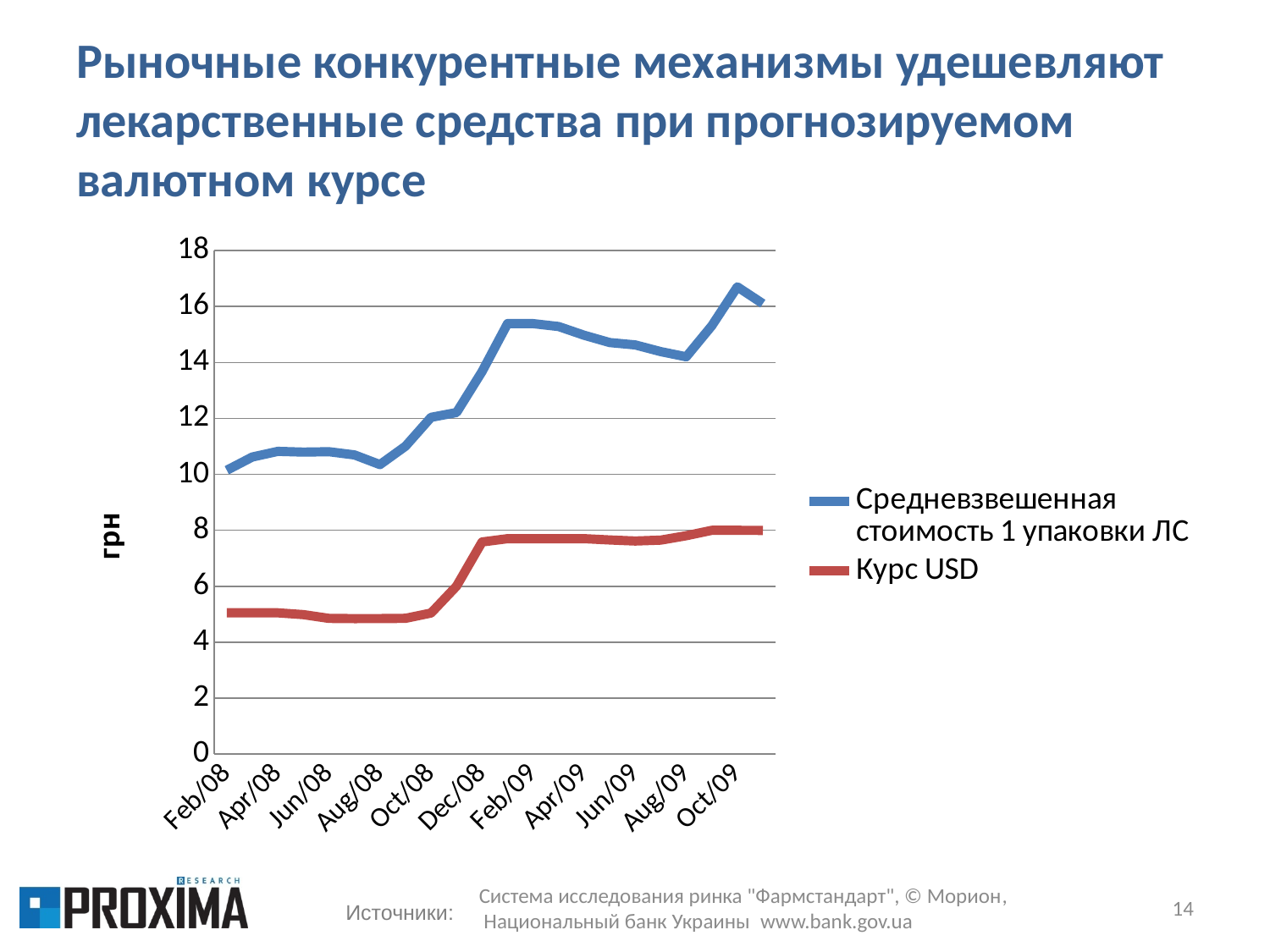
Is the value for Средневзвешенная стоимость 1 упаковки ЛС at Feb/08 greater or less than 12? less Is the value for Средневзвешенная стоимость 1 упаковки ЛС at Feb/09 greater or less than 14? greater Is the value for Средневзвешенная стоимость 1 упаковки ЛС at Aug/08 greater or less than 12? less Overall, does the Курс USD line rise or fall from Feb/08 to Oct/09? rise What kind of chart is shown on the slide? line chart What are the two series named in the legend? Средневзвешенная стоимость 1 упаковки ЛС; Курс USD Overall, does the Средневзвешенная стоимость 1 упаковки ЛС line rise or fall from Feb/08 to Oct/09? rise Which series has the higher value at Oct/09, Средневзвешенная стоимость 1 упаковки ЛС or Курс USD? Средневзвешенная стоимость 1 упаковки ЛС How many series does the legend list? 2 What is the label on the vertical axis? грн